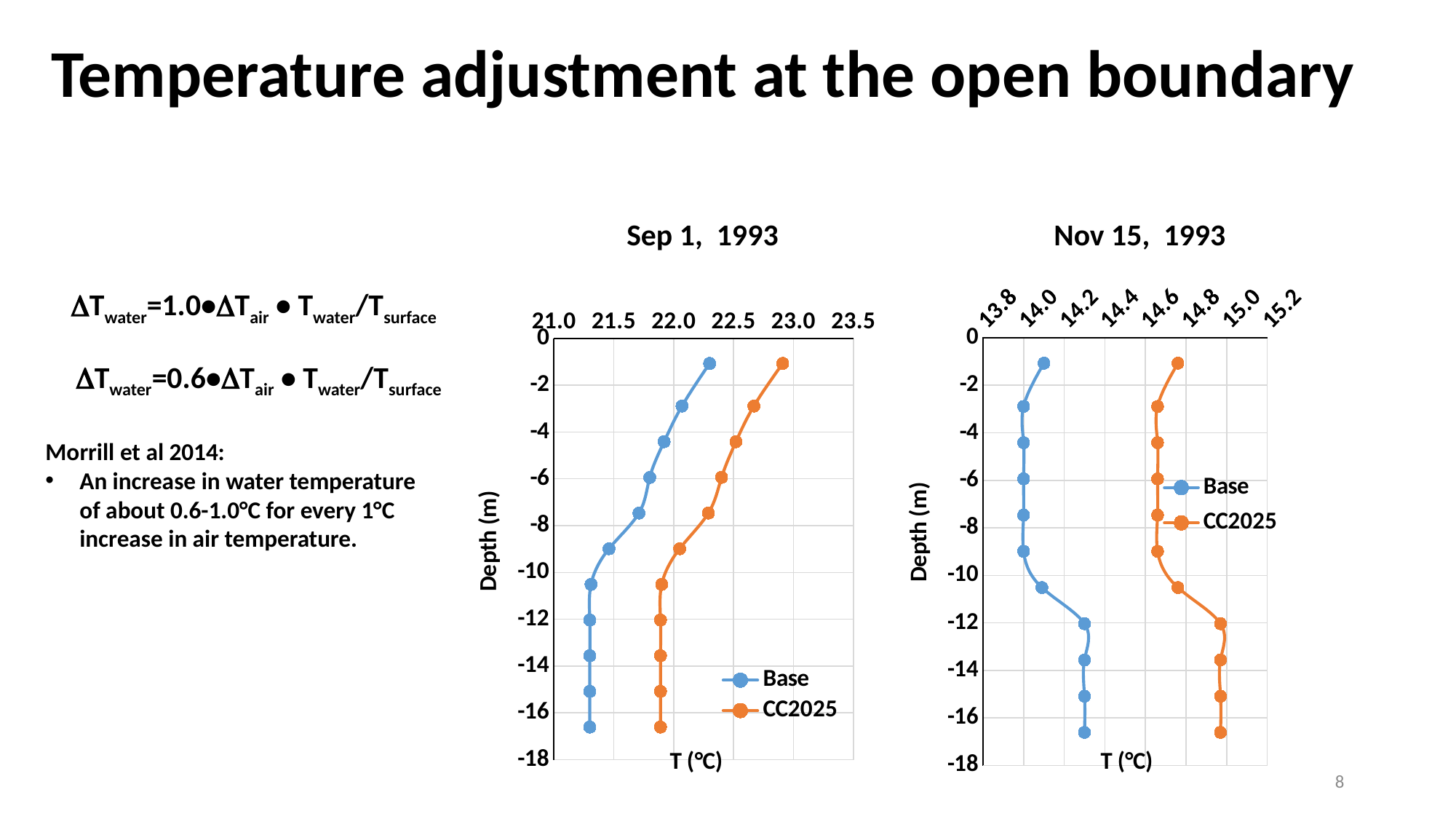
In the Sep 1, 1993 chart, is the CC2025 temperature at a depth of -16.5 m greater or less than 22.0? less What kind of chart is the Sep 1, 1993 chart? line chart In the Nov 15, 1993 chart, is the CC2025 temperature at a depth of -16.5 m greater or less than 14.6? greater What are the two series named in the legend of the Sep 1, 1993 chart? Base and CC2025 In the Sep 1, 1993 chart, is the Base temperature at a depth of -1 m greater or less than 22.0? greater In the Sep 1, 1993 chart, which series has the higher temperature at a depth of -1 m, Base or CC2025? CC2025 In the Nov 15, 1993 chart, which series has the higher temperature at a depth of -12 m, Base or CC2025? CC2025 What is the y-axis title of the Sep 1, 1993 chart? Depth (m) How many series does the legend of the Nov 15, 1993 chart list? 2 How many data points does the Base series have in the Sep 1, 1993 chart? 11